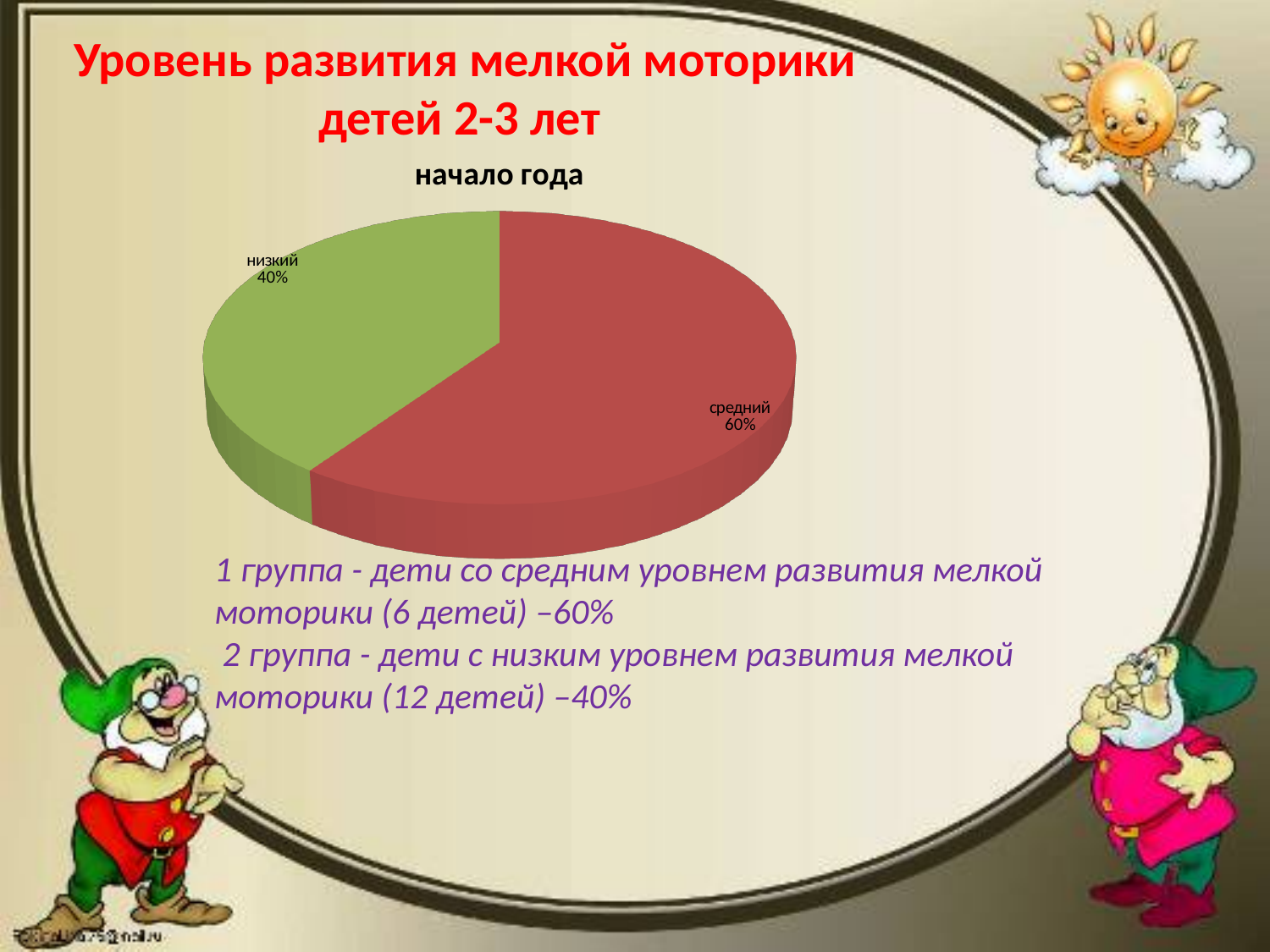
Which slice is larger, "средний" or "низкий"? средний What share of the pie does the "средний" slice have? 60% Which slice is the smallest in the pie chart? низкий How many slices does the pie chart have? 2 Which slice is the largest in the pie chart? средний What is the chart's title? начало года What kind of chart is shown on the slide? pie chart What is the difference in percentage points between the "средний" and "низкий" slices? 20% Is the share of the "средний" slice greater or less than 50%? greater What share of the pie does the "низкий" slice have? 40% What colour is the "низкий" slice? green